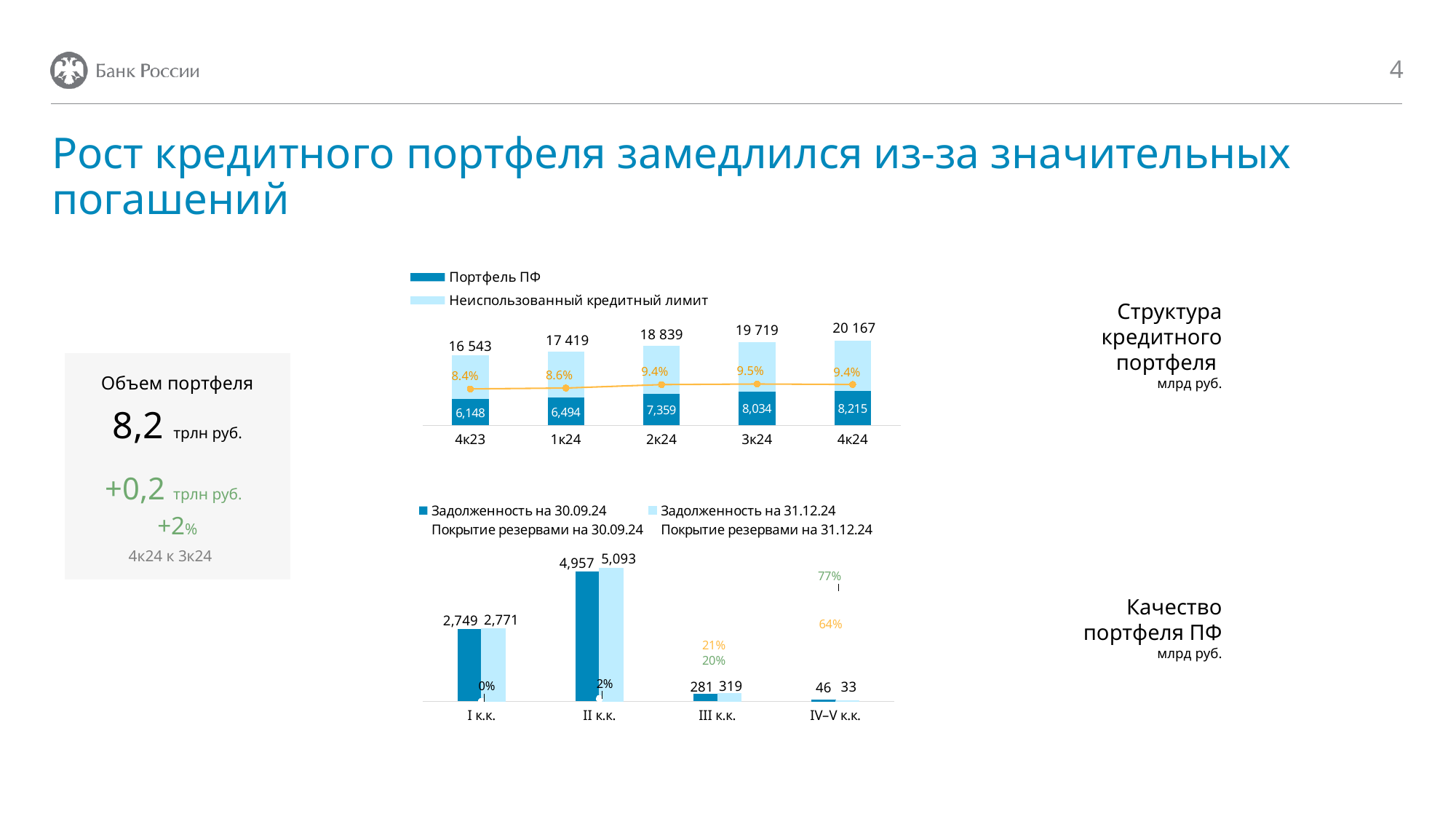
In the top chart (Структура кредитного портфеля), which quarter has the lowest Портфель ПФ value? 4к23 In the bottom chart (Качество портфеля ПФ), what is the Задолженность на 31.12.24 for II к.к.? 5,093 What type of chart is the bottom chart (Качество портфеля ПФ)? bar chart In the top chart (Структура кредитного портфеля), what percentage is shown on the line for 3к24? 9.5% In the bottom chart (Качество портфеля ПФ), which category has the highest Задолженность на 30.09.24? II к.к. In the top chart (Структура кредитного портфеля), does the Портфель ПФ value rise or fall from 4к23 to 4к24? rise In the top chart (Структура кредитного портфеля), what is the total shown above the bar for 2к24? 18 839 In the bottom chart (Качество портфеля ПФ), what is the Задолженность на 30.09.24 for III к.к.? 281 In the bottom chart (Качество портфеля ПФ), which is larger for IV–V к.к.: Задолженность на 30.09.24 or Задолженность на 31.12.24? Задолженность на 30.09.24 In the top chart (Структура кредитного портфеля), how many quarters are shown on the x axis? 5 In the top chart (Структура кредитного портфеля), what is the value of Портфель ПФ for 4к24? 8,215 In the top chart (Структура кредитного портфеля), what is the difference between the Портфель ПФ values for 1к24 and 4к23? 346